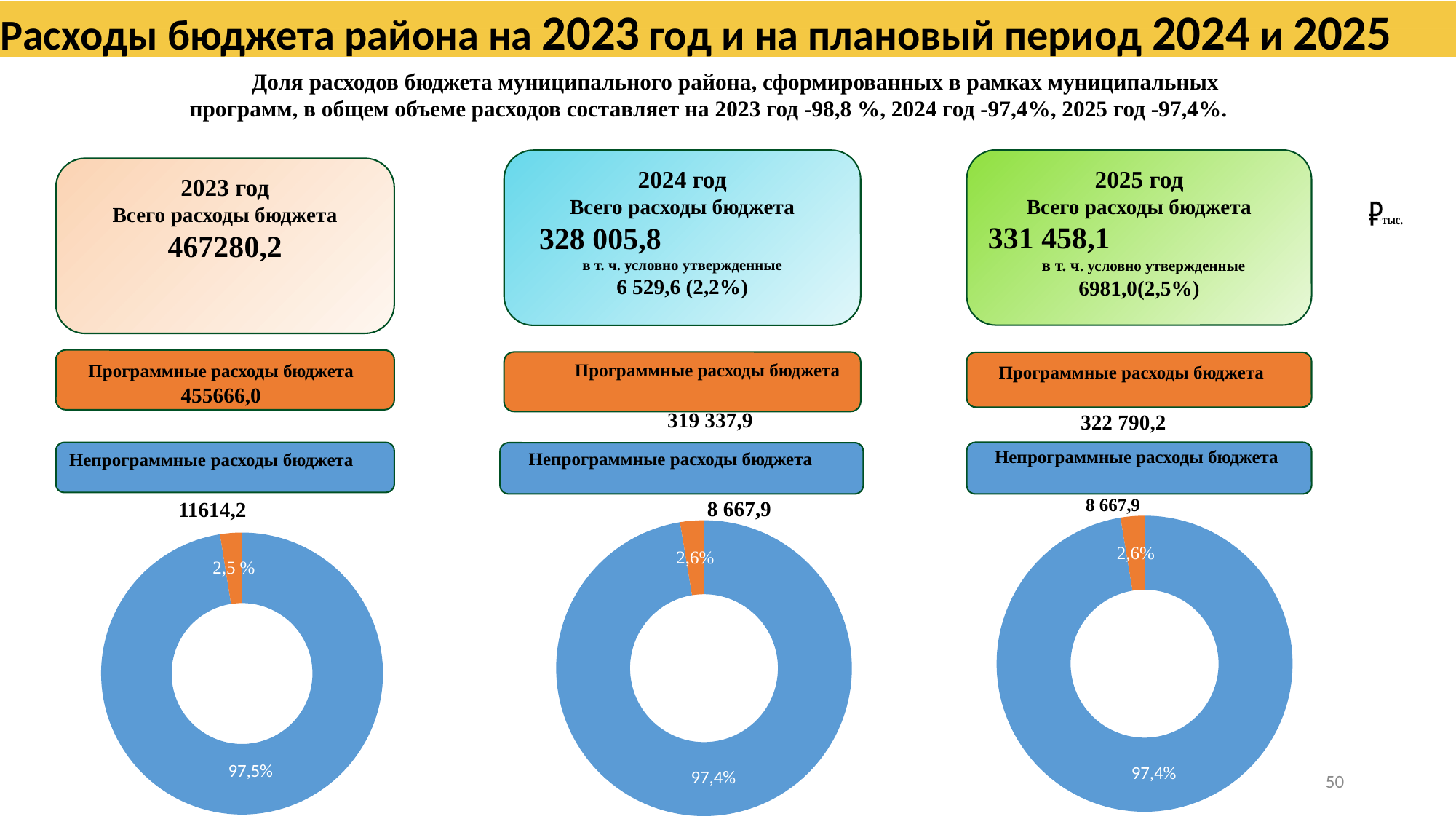
How many donut charts are on the slide? 3 What kind of chart is shown under the 2023 год box? pie chart (donut) How many slices does the 2023 год donut chart have? 2 In the 2024 год donut chart, what percentage is shown on the small orange slice? 2,6% What colour is the largest slice in each of the three donut charts? blue In the 2025 год donut chart, what percentage is shown on the small orange slice? 2,6% In the 2024 год donut chart, what percentage is shown on the large blue slice? 97,4% In the 2025 год donut chart, what percentage is shown on the large blue slice? 97,4% In the 2023 год donut chart, what percentage is shown on the small orange slice? 2,5 % In the 2023 год donut chart, what is the difference in percentage points between the blue slice and the orange slice? 95 percentage points In the 2023 год donut chart, what percentage is shown on the large blue slice? 97,5% In the 2024 год donut chart, which slice is larger, the blue one or the orange one? blue